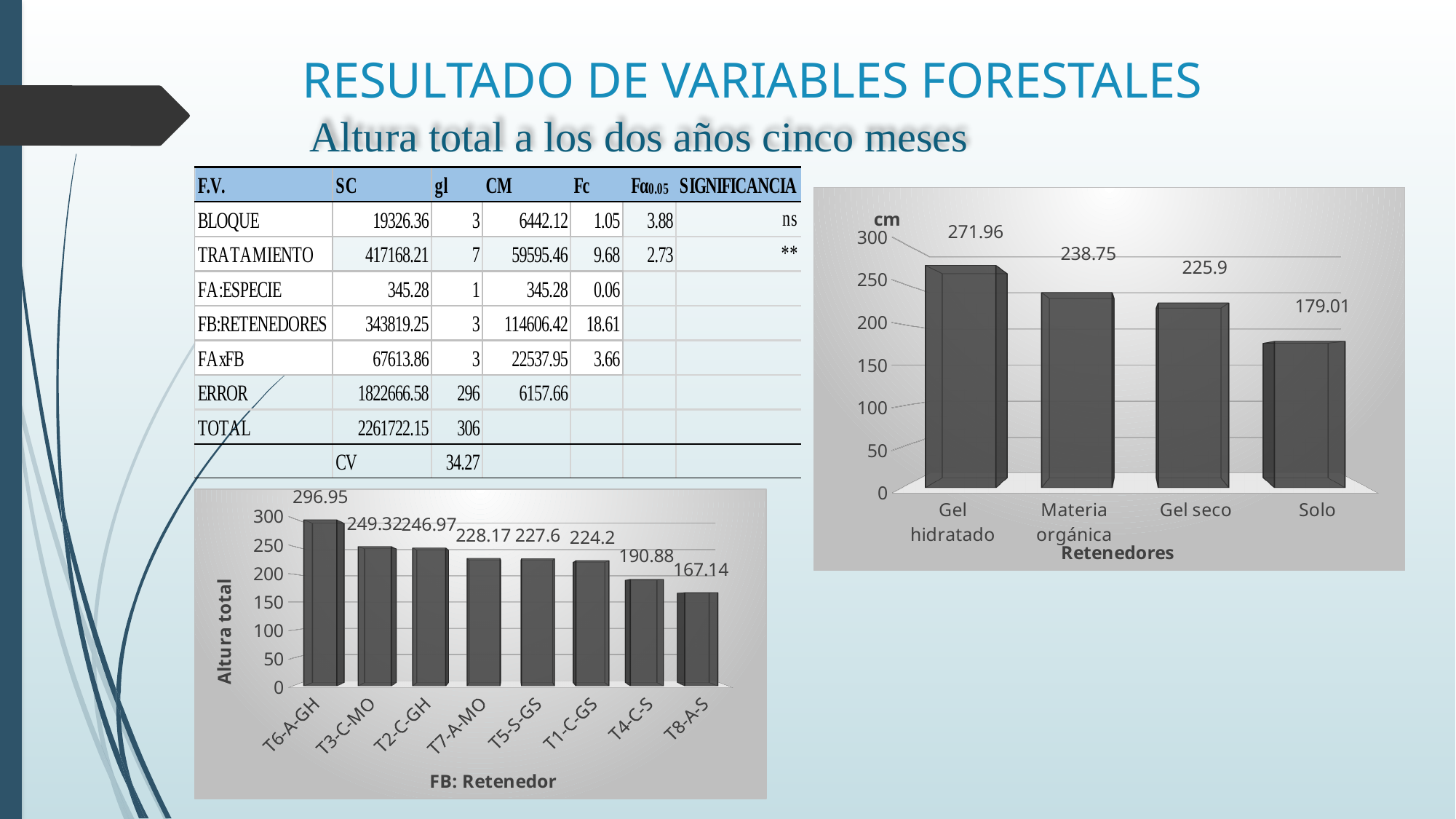
In the chart at the bottom left (x axis 'FB: Retenedor'), what is the difference between T6-A-GH and T8-A-S? 129.81 In the chart at the bottom left (x axis 'FB: Retenedor'), do the values rise or fall from left to right? fall In the chart on the right (x axis 'Retenedores'), how many bars are plotted? 4 In the chart at the bottom left (x axis 'FB: Retenedor'), how many categories are shown on the x axis? 8 In the chart at the bottom left (x axis 'FB: Retenedor'), which category has the highest value? T6-A-GH What kind of chart is the one at the bottom left (x axis 'FB: Retenedor')? bar chart In the chart at the bottom left (x axis 'FB: Retenedor'), which is larger, T4-C-S or T8-A-S? T4-C-S In the chart at the bottom left (x axis 'FB: Retenedor'), what is the value for T7-A-MO? 228.17 In the chart on the right (x axis 'Retenedores'), is the value for Gel seco greater or less than 200? greater In the chart on the right (x axis 'Retenedores'), what is the value for Gel hidratado? 271.96 In the chart on the right (x axis 'Retenedores'), what is the difference between Gel hidratado and Solo? 92.95 In the chart on the right (x axis 'Retenedores'), which category has the lowest value? Solo